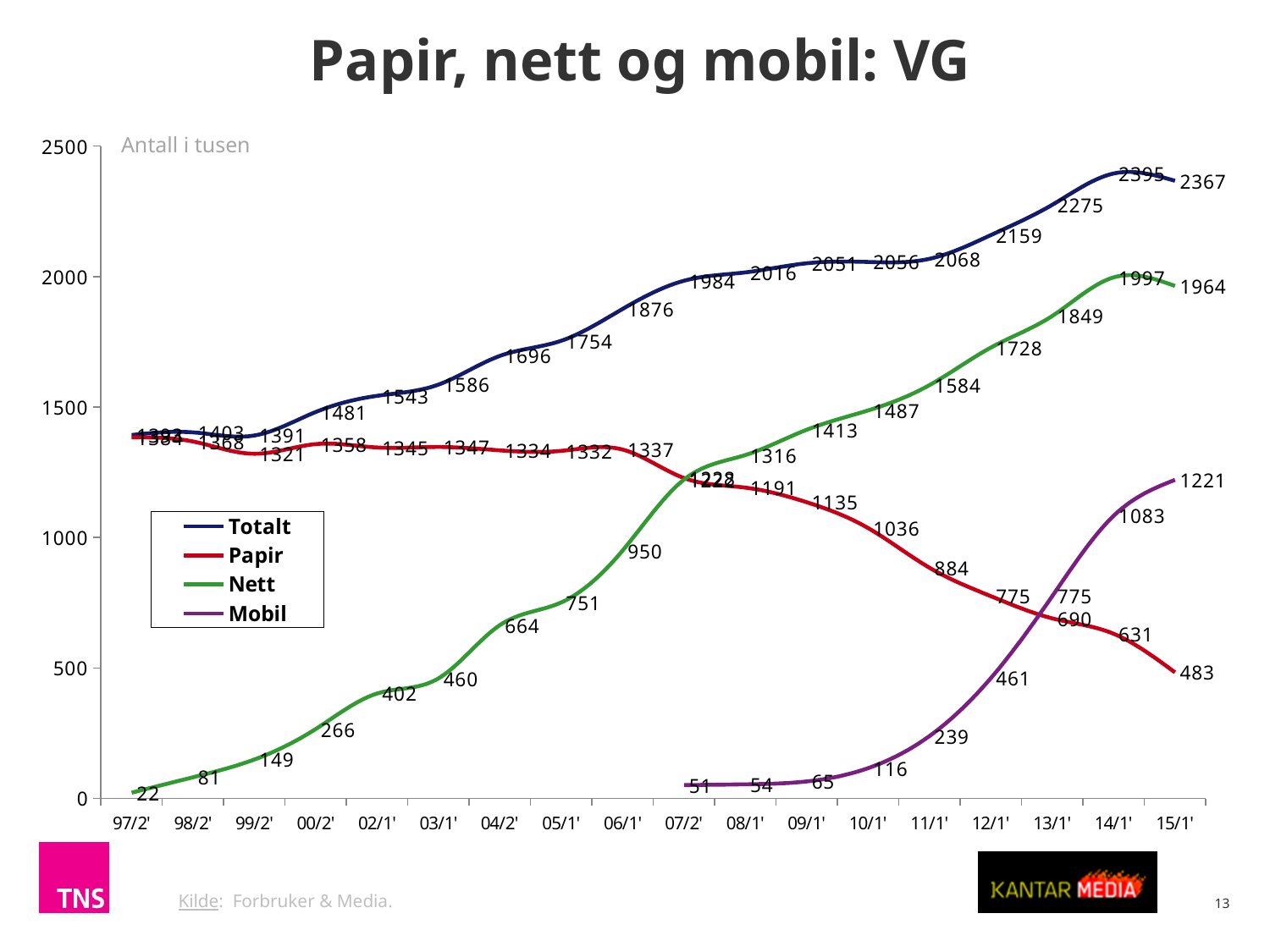
Does the Papir series rise or fall from 06/1' to 15/1'? fall At which x-axis point does the Totalt series reach its highest value? 14/1' What label is shown at the top of the y axis? Antall i tusen What is the difference between Nett and Mobil at 15/1'? 743 How many series does the legend list? 4 What kind of chart is shown on the slide? line chart What is the value of Papir at 15/1'? 483 What is the value of Mobil at 15/1'? 1221 What is the value of Nett at 14/1'? 1997 At which x-axis point is the Nett series lowest? 97/2' What is the value of Totalt at 15/1'? 2367 At 13/1', which is larger: Papir or Mobil? Mobil